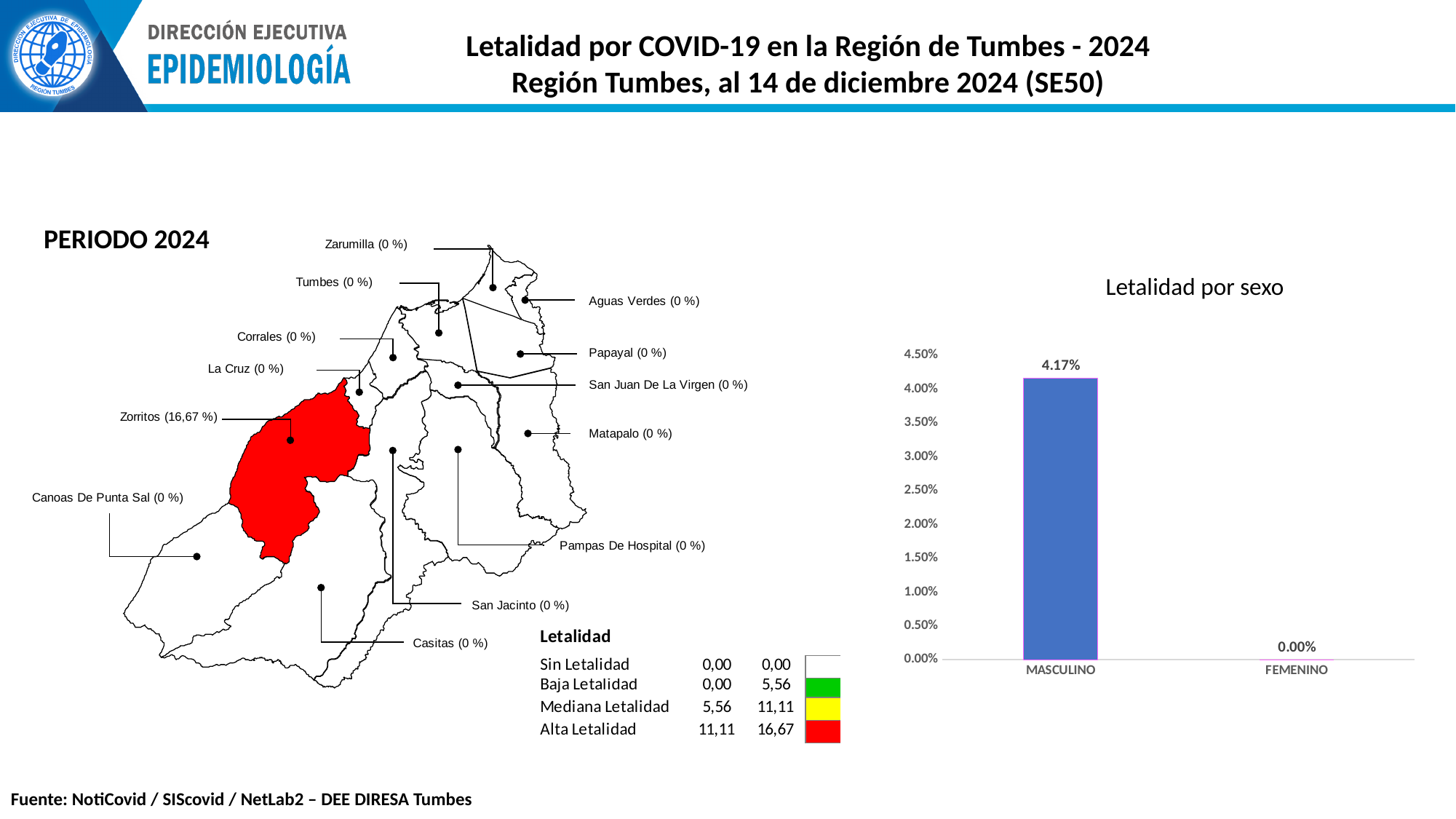
In the 'Letalidad por sexo' chart, what is the highest value shown on the y axis? 4.50% In the 'Letalidad por sexo' chart, what is the value for MASCULINO? 4.17% In the 'Letalidad por sexo' chart, what is the difference between the MASCULINO and FEMENINO values? 4.17% In the 'Letalidad por sexo' chart, which category has the highest value? MASCULINO On the map on the left, which district has the highest lethality? Zorritos On the map on the left, what is the lethality value shown for Zorritos? 16,67 % In the 'Letalidad por sexo' chart, which category has the lowest value? FEMENINO In the map legend, what range is given for 'Alta Letalidad'? 11,11 to 16,67 In the 'Letalidad por sexo' chart, what is the value for FEMENINO? 0.00% What kind of chart is 'Letalidad por sexo'? bar chart In the 'Letalidad por sexo' chart, how many categories are shown on the x axis? 2 In the 'Letalidad por sexo' chart, is the value for MASCULINO greater or less than 4.00%? greater